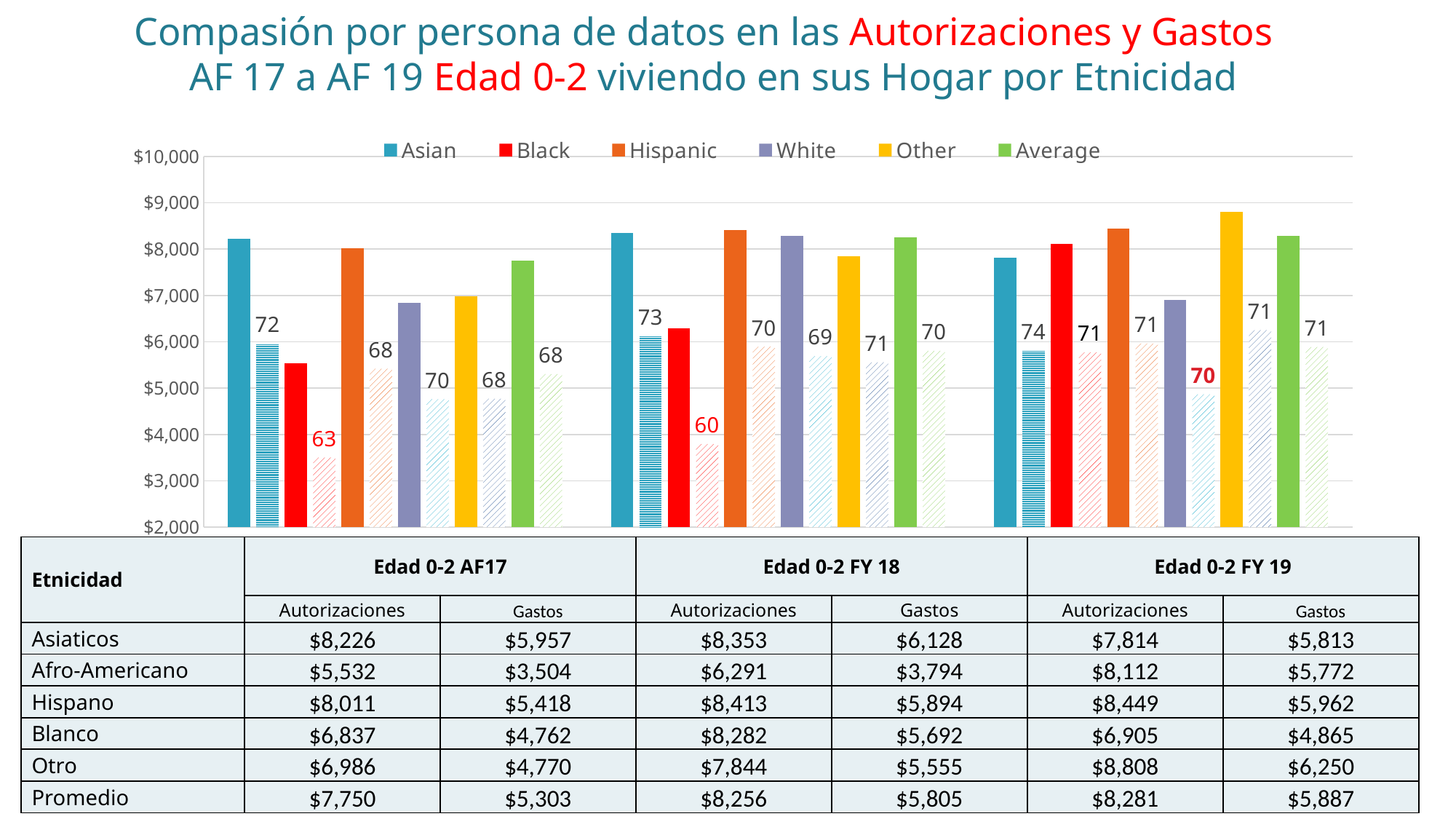
What is the Autorizaciones value for Otro in Edad 0-2 FY 19? $8,808 Is the Black Autorizaciones bar for AF17 greater or less than $6,000? less What kind of chart is shown on the slide? bar chart Do the Autorizaciones values for Afro-Americano rise or fall from AF17 to FY 19? rise Which ethnicity has the lowest Autorizaciones value in Edad 0-2 AF17? Afro-Americano Which ethnicity has the highest Autorizaciones value in Edad 0-2 FY 19? Otro How many fiscal-year groups are plotted along the x axis? 3 What is the difference between Autorizaciones and Gastos for Asiaticos in Edad 0-2 AF17? $2,269 How many series does the chart legend list? 6 What is the Autorizaciones value for Asiaticos in Edad 0-2 AF17? $8,226 What is the Gastos value for Afro-Americano in Edad 0-2 FY 18? $3,794 Which is larger in Edad 0-2 AF17: the Autorizaciones value for Afro-Americano or for Blanco? Blanco